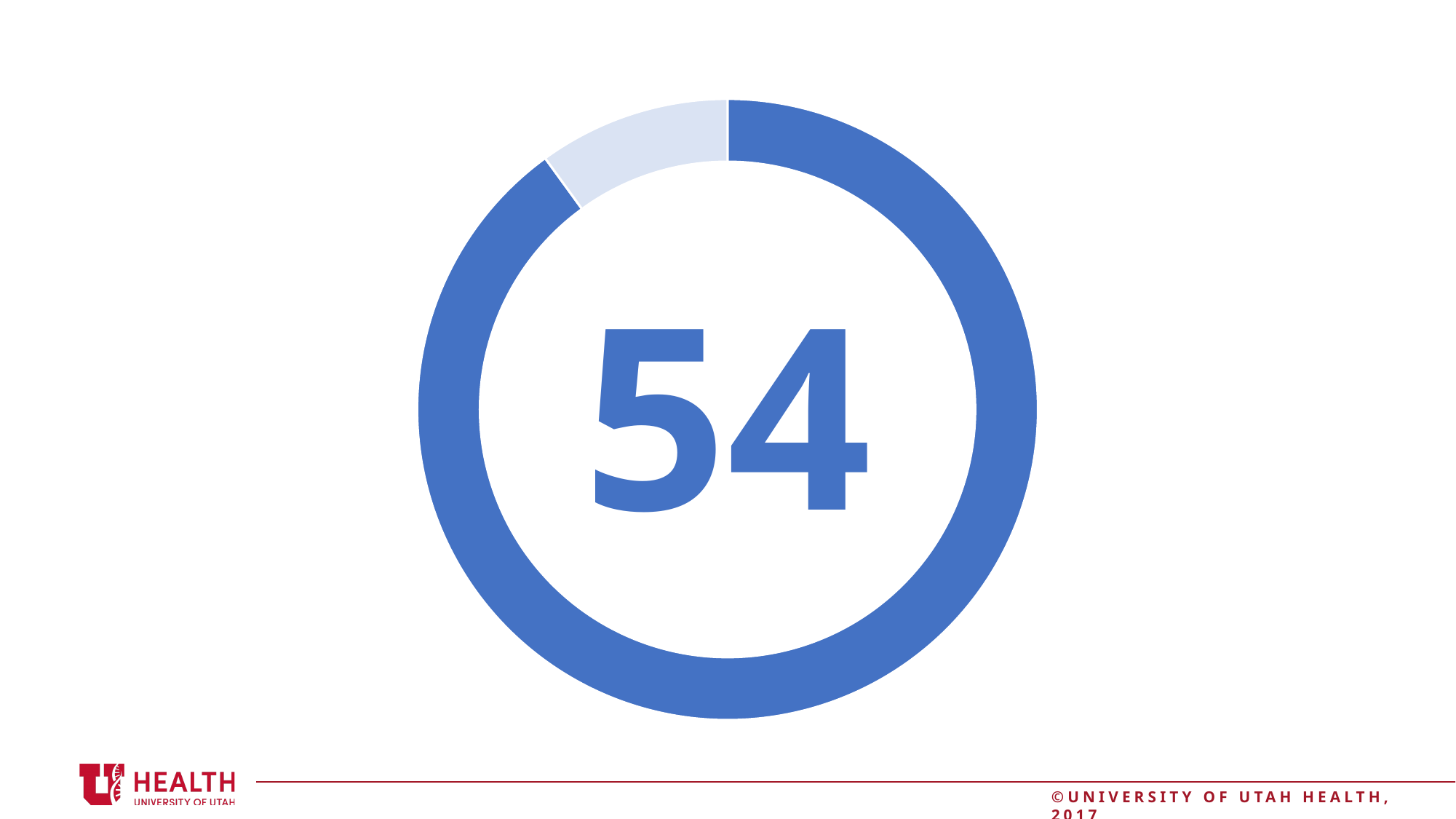
What colour is the larger segment of the doughnut chart? Dark blue How many segments does the doughnut chart have? 2 Which segment of the doughnut chart is larger, the dark blue one or the light blue one? The dark blue one What number is displayed in the centre of the doughnut chart? 54 Does the dark blue segment cover more or less than half of the ring? More Which segment of the doughnut chart is the smallest? The light blue segment What kind of chart is shown on the slide? Doughnut chart